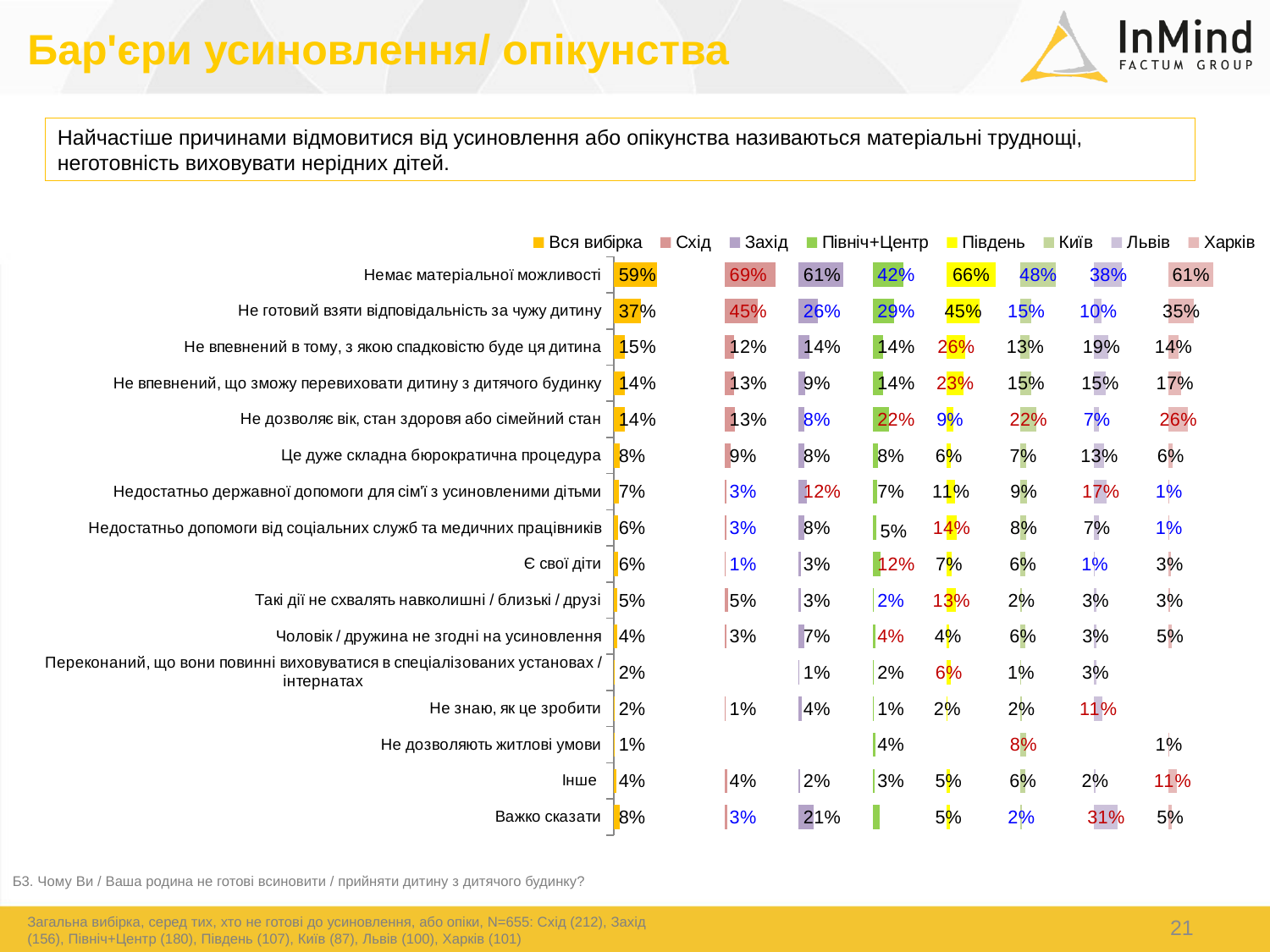
In the category 'Це дуже складна бюрократична процедура', which is larger: the value for 'Київ' or for 'Львів'? Львів What is the value for 'Вся вибірка' in the category 'Немає матеріальної можливості'? 59% How many series does the chart legend list? 8 What is the difference between 'Схід' and 'Львів' in the category 'Немає матеріальної можливості'? 31 percentage points What kind of chart is shown on the slide? bar chart How many categories (reasons) are plotted in the chart? 16 Which series has the highest value in the category 'Немає матеріальної можливості'? Схід What is the title of the slide containing the chart? Бар'єри усиновлення/ опікунства Which series has the lowest value in the category 'Немає матеріальної можливості'? Львів What is the value for 'Харків' in the category 'Не дозволяє вік, стан здоров'я або сімейний стан'? 26% What is the value for 'Львів' in the category 'Важко сказати'? 31% What is the value for 'Схід' in the category 'Не готовий взяти відповідальність за чужу дитину'? 45%